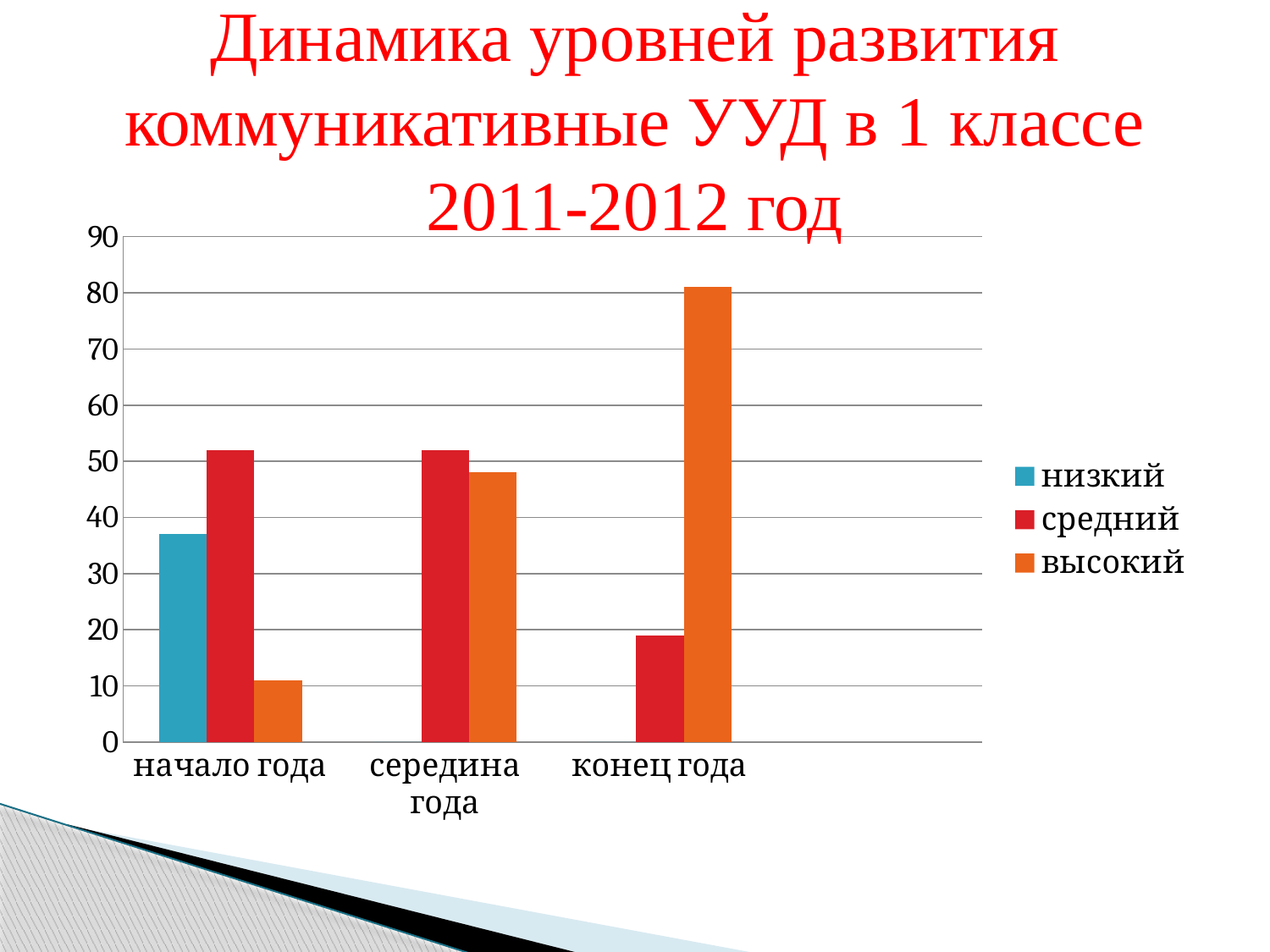
Is the value for 'низкий' in 'начало года' greater or less than 40? less What kind of chart is shown on the slide? bar chart How many categories are shown on the x axis? 3 Which is larger: 'высокий' in 'середина года' or 'высокий' in 'конец года'? 'высокий' in 'конец года' Which colour represents the 'средний' series in the legend? red Does the value for 'высокий' rise or fall from 'начало года' to 'конец года'? rise Which series has the shortest bar in the 'начало года' category? высокий Is the value for 'высокий' in 'начало года' greater or less than 20? less How many series does the legend list? 3 Which series has the tallest bar in the 'конец года' category? высокий